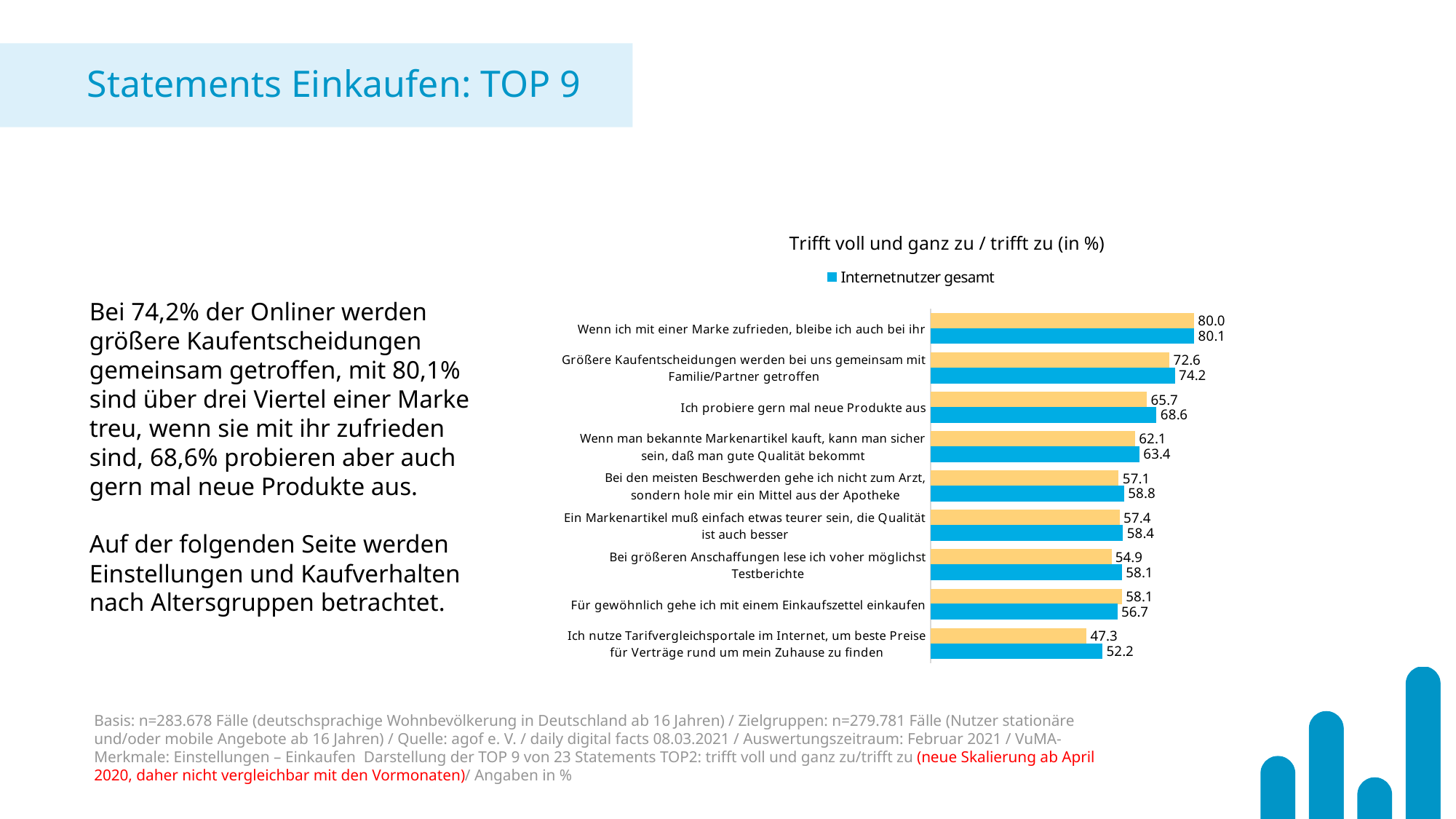
What is the Internetnutzer gesamt value for "Wenn ich mit einer Marke zufrieden, bleibe ich auch bei ihr"? 80.1 Which statement has the highest Internetnutzer gesamt value? Wenn ich mit einer Marke zufrieden, bleibe ich auch bei ihr What is the Internetnutzer gesamt value for "Ich probiere gern mal neue Produkte aus"? 68.6 For Internetnutzer gesamt, which is larger: "Bei größeren Anschaffungen lese ich voher möglichst Testberichte" or "Für gewöhnlich gehe ich mit einem Einkaufszettel einkaufen"? Bei größeren Anschaffungen lese ich voher möglichst Testberichte What is the difference between the Internetnutzer gesamt values for "Größere Kaufentscheidungen werden bei uns gemeinsam mit Familie/Partner getroffen" and "Ich probiere gern mal neue Produkte aus"? 5.6 What is the title shown above the chart? Trifft voll und ganz zu / trifft zu (in %) What is the Internetnutzer gesamt value for "Ich nutze Tarifvergleichsportale im Internet, um beste Preise für Verträge rund um mein Zuhause zu finden"? 52.2 How many statements (categories) are plotted in the chart? 9 Which statement has the lowest Internetnutzer gesamt value? Ich nutze Tarifvergleichsportale im Internet, um beste Preise für Verträge rund um mein Zuhause zu finden What kind of chart is shown on the slide? bar chart How many series does the chart legend list? 1 What is the name of the series listed in the chart legend? Internetnutzer gesamt